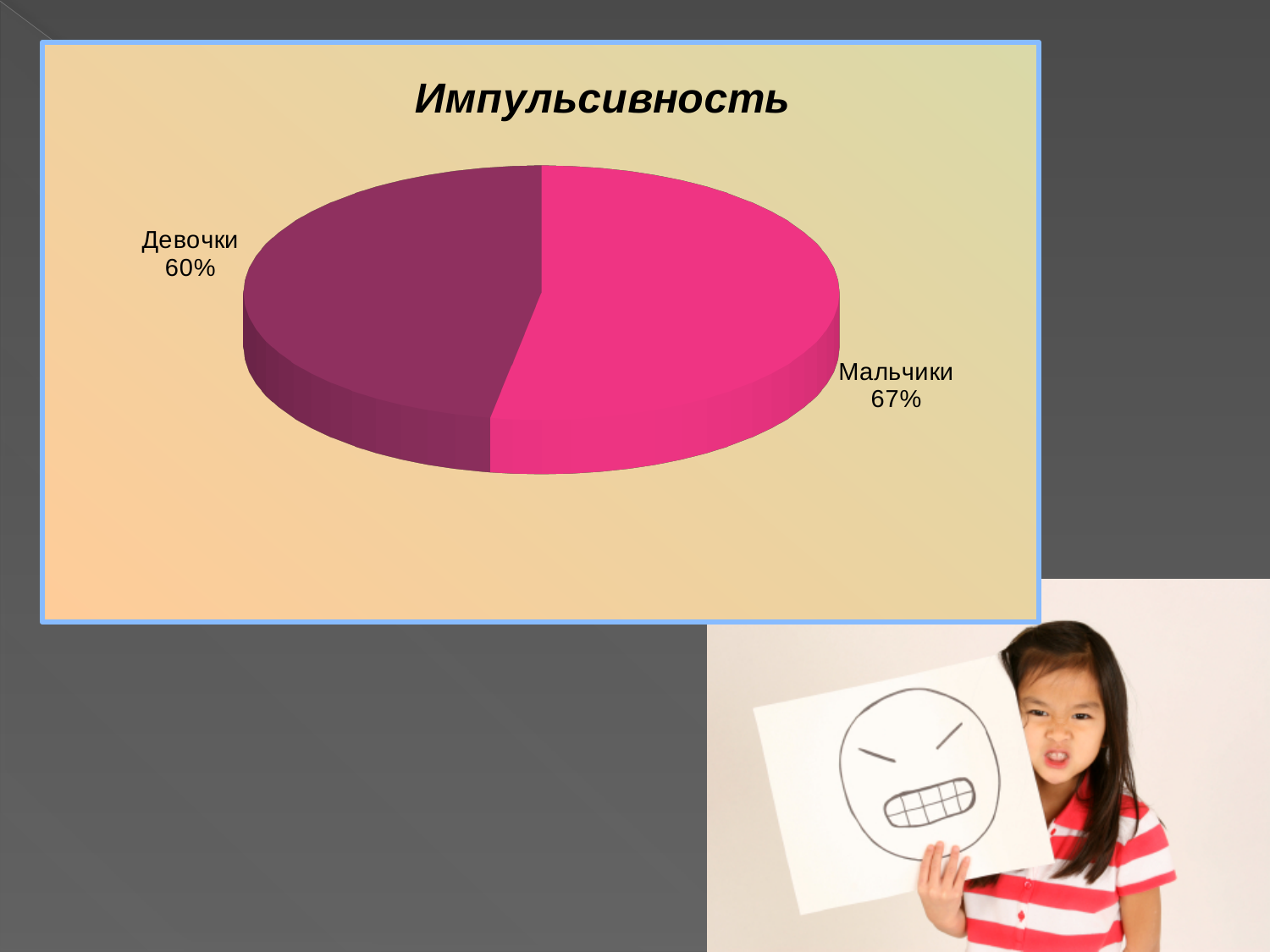
Which slice of the pie is larger, the one for Девочки or the one for Мальчики? Мальчики What is the difference between the values for Мальчики and Девочки? 7% What value is shown for Мальчики? 67% Which category has the highest value in the chart? Мальчики What are the two categories labelled on the pie chart? Девочки and Мальчики What value is shown for Девочки? 60% What is the title of the chart? Импульсивность What type of chart is shown on the slide? pie chart How many categories (slices) does the pie chart have? 2 Which category has the higher value, Девочки or Мальчики? Мальчики Which category has the lowest value in the chart? Девочки